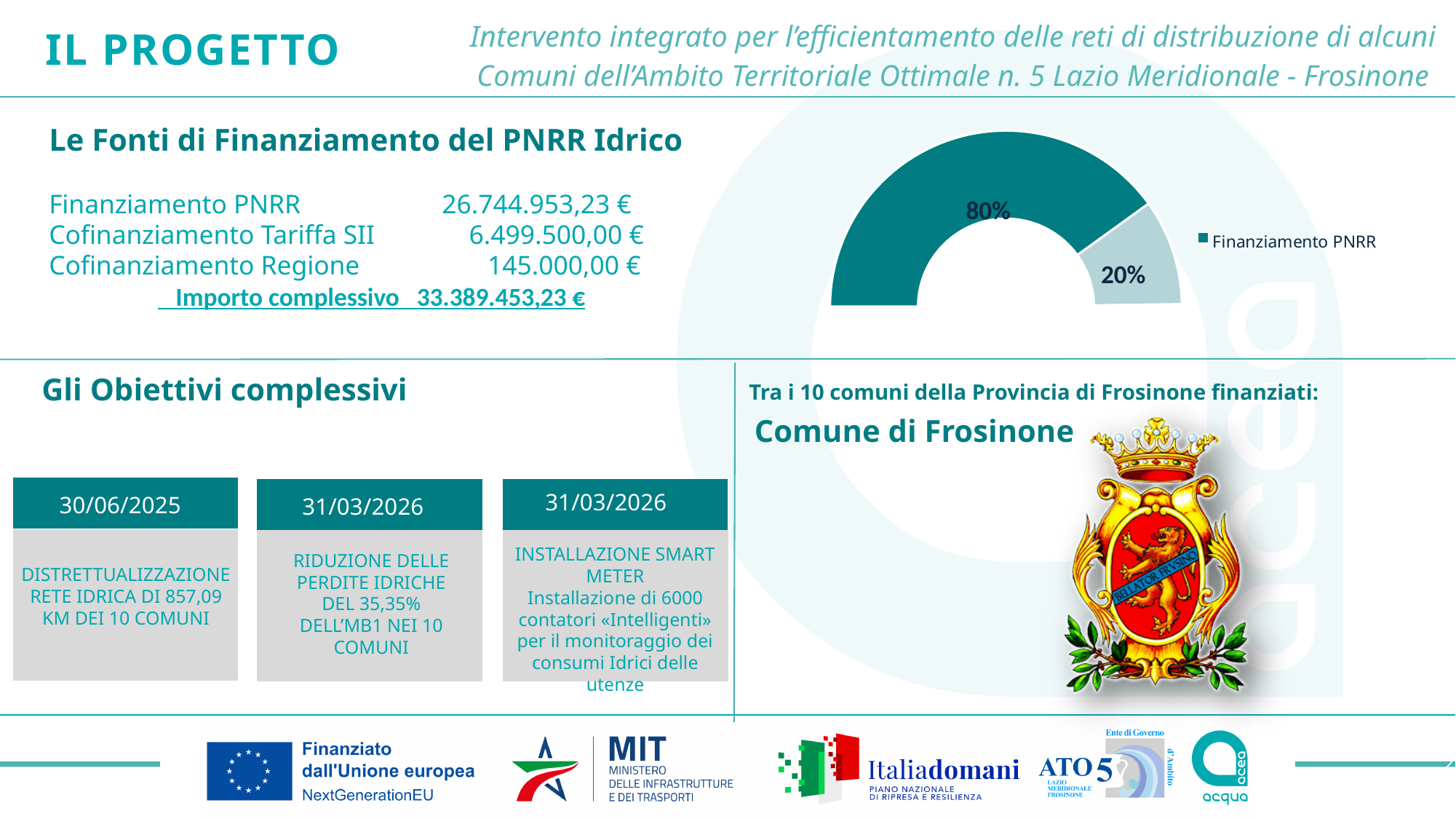
What is the total of the two percentages shown on the chart? 100% What percentage is printed on the lighter-coloured slice of the chart? 20% How many entries does the chart legend list? 1 What is the difference in percentage points between the two slices of the chart? 60 How many slices does the chart have? 2 What kind of chart is shown on the slide? Doughnut (pie) chart Is the share of the Finanziamento PNRR slice greater or less than 50%? greater Which slice of the chart is the smallest? The 20% slice Which slice is larger: the Finanziamento PNRR slice or the lighter slice? Finanziamento PNRR What share of the chart does the Finanziamento PNRR slice represent? 80% What is the only entry shown in the chart legend? Finanziamento PNRR What colour is the Finanziamento PNRR slice in the chart? Dark teal